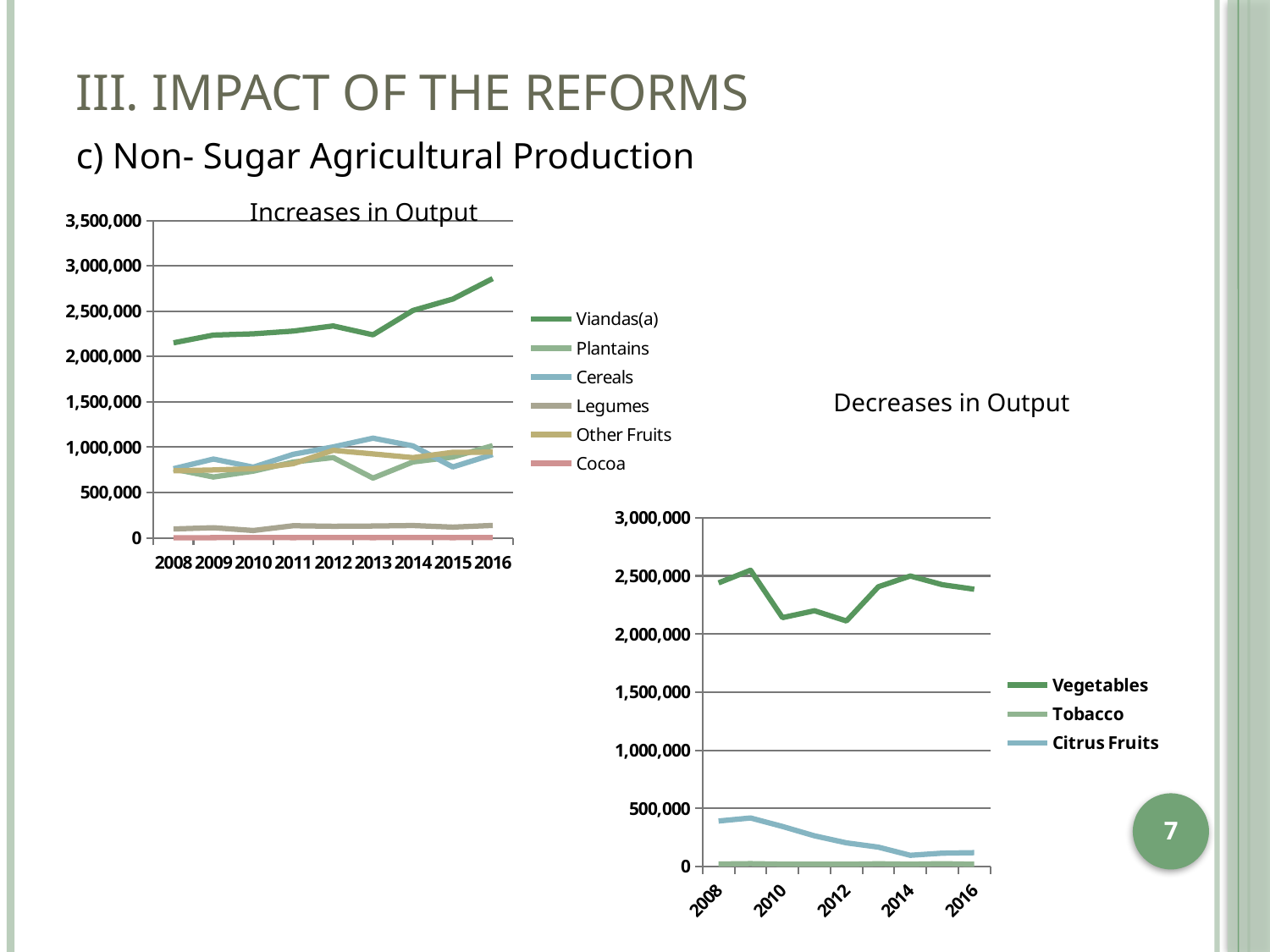
How many series does the legend of the "Increases in Output" chart list? 6 In the "Increases in Output" chart, is the value for Viandas(a) in 2016 greater or less than 2,500,000? greater What kind of chart is the "Increases in Output" chart? line chart In the "Decreases in Output" chart, which series is larger in 2008, Vegetables or Citrus Fruits? Vegetables How many years are labelled on the x axis of the "Increases in Output" chart? 9 In the "Decreases in Output" chart, is the value for Citrus Fruits in 2008 greater or less than 500,000? less In the "Increases in Output" chart, does the Viandas(a) line generally rise or fall from 2008 to 2016? rise In the "Increases in Output" chart, is the value for Viandas(a) in 2008 greater or less than 2,500,000? less In the "Increases in Output" chart, which series has the highest value in 2016? Viandas(a) How many series does the legend of the "Decreases in Output" chart list? 3 In the "Increases in Output" chart, which series has the lowest values across all years? Cocoa In the "Decreases in Output" chart, does the Citrus Fruits line rise or fall from 2008 to 2016? fall